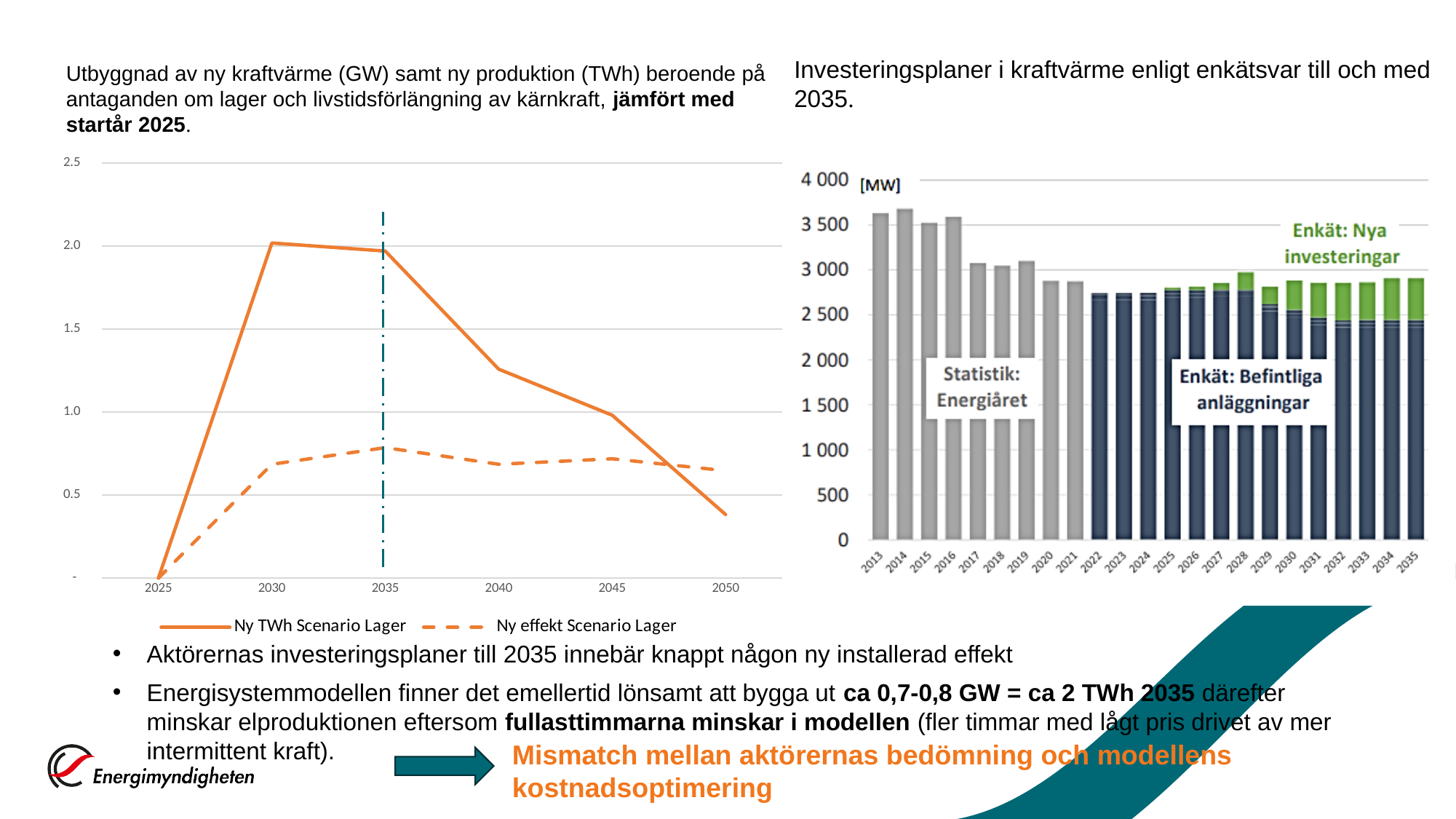
What kind of chart is the right chart (Investeringsplaner i kraftvärme)? bar chart In the left chart, which series has the larger value in 2050, Ny TWh Scenario Lager or Ny effekt Scenario Lager? Ny effekt Scenario Lager In the left chart, is the value of Ny TWh Scenario Lager in 2040 greater or less than 1.0? greater In the left chart, does Ny TWh Scenario Lager rise or fall between 2035 and 2050? fall In the left chart, is the value of Ny TWh Scenario Lager in 2050 greater or less than 0.5? less In the left chart, how many year labels are shown on the x axis? 6 In the left chart, how many series does the legend list? 2 In the right chart, how many years are shown on the x axis? 23 In the left chart, in which year is Ny TWh Scenario Lager lowest? 2025 In the right chart, what unit is shown at the top of the y axis? MW In the right chart, is the bar for 2020 greater or less than 3 000 MW? less What kind of chart is the left chart (Utbyggnad av ny kraftvärme)? line chart